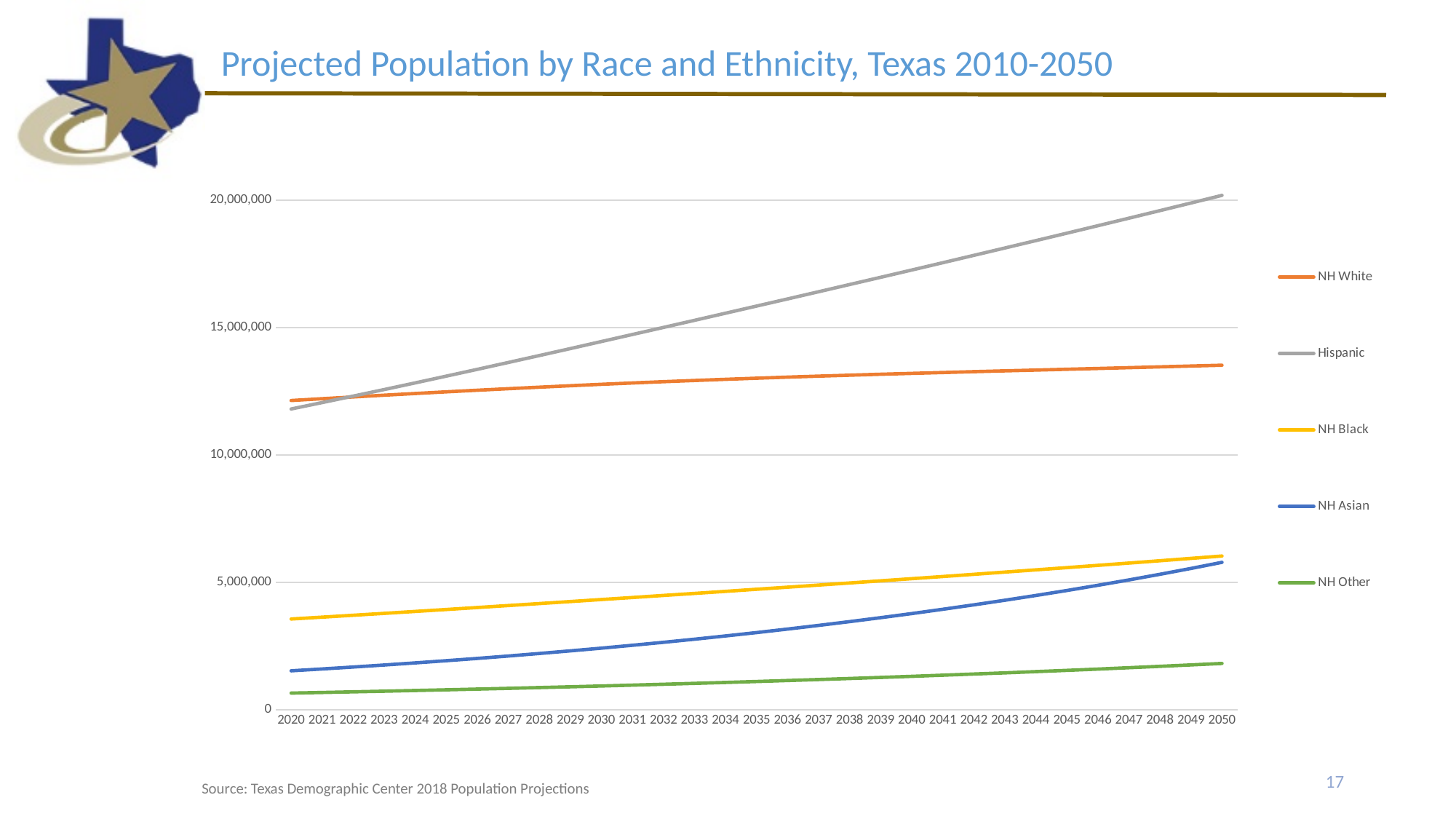
What kind of chart is shown on the slide? line chart What is the title of the chart? Projected Population by Race and Ethnicity, Texas 2010-2050 Is the value for Hispanic in 2020 greater or less than 15,000,000? less Is the value for NH Asian in 2050 greater or less than 5,000,000? greater Which series has the highest projected population in 2050? Hispanic In 2050, which is larger: Hispanic or NH White? Hispanic Does the Hispanic population rise or fall from 2020 to 2050? rise How many series does the legend list? 5 Which series has the highest projected population in 2020? NH White Which series has the lowest projected population in 2050? NH Other How many years are shown along the x axis? 31 Is the value for NH Black in 2020 greater or less than 5,000,000? less